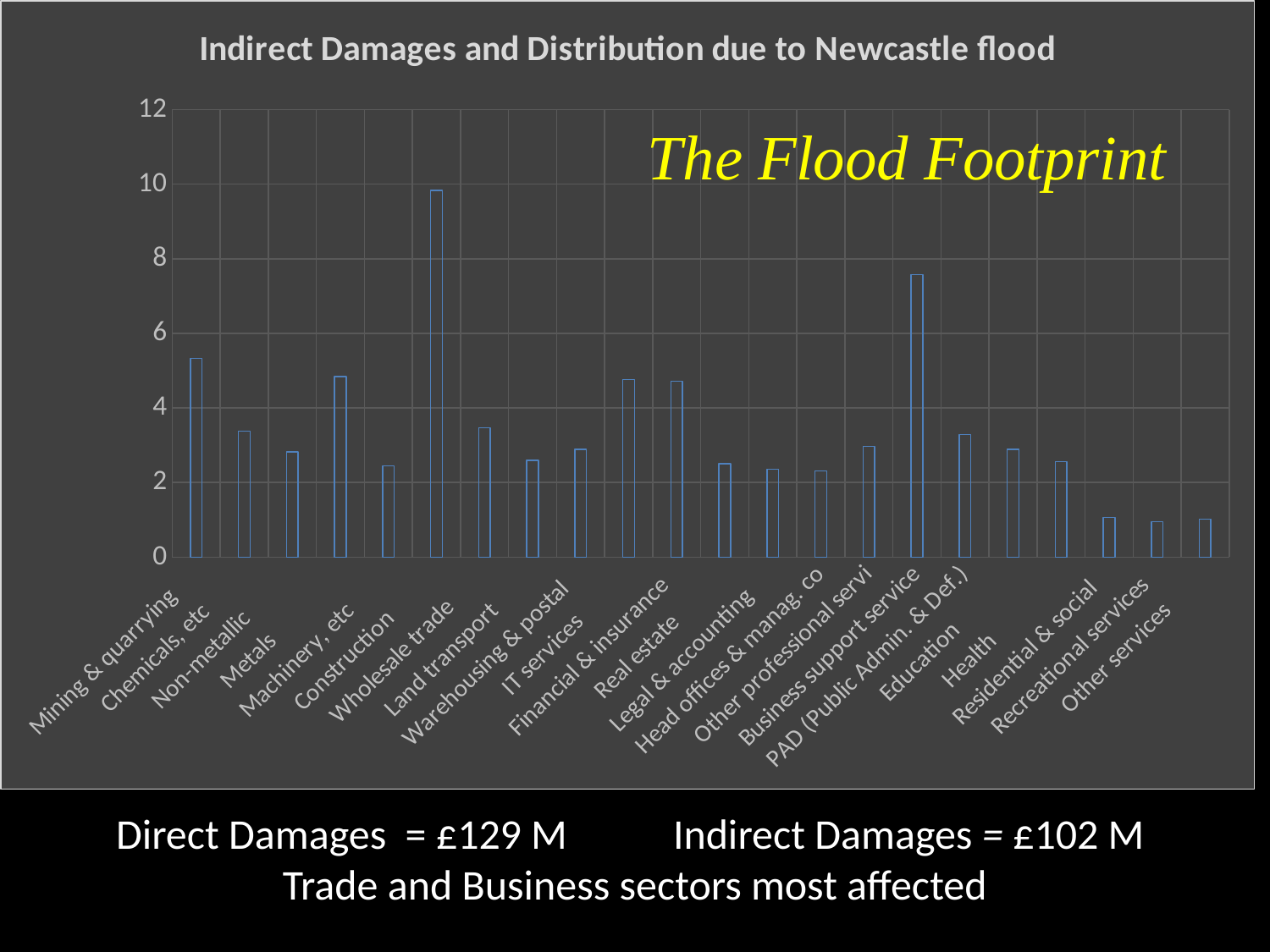
What kind of chart is shown on the slide? bar chart Is the value for Mining & quarrying greater or less than 4? greater What is the highest value shown on the vertical axis? 12 Is the value for Recreational services greater or less than 2? less Is the value for Chemicals, etc greater or less than 4? less Which is larger, the value for Wholesale trade or the value for Business support service? Business support service Which sector has the highest value? Construction Which is larger, the value for Mining & quarrying or the value for Metals? Mining & quarrying How many sectors (categories) are plotted on the x axis? 22 What is the title of the chart? Indirect Damages and Distribution due to Newcastle flood